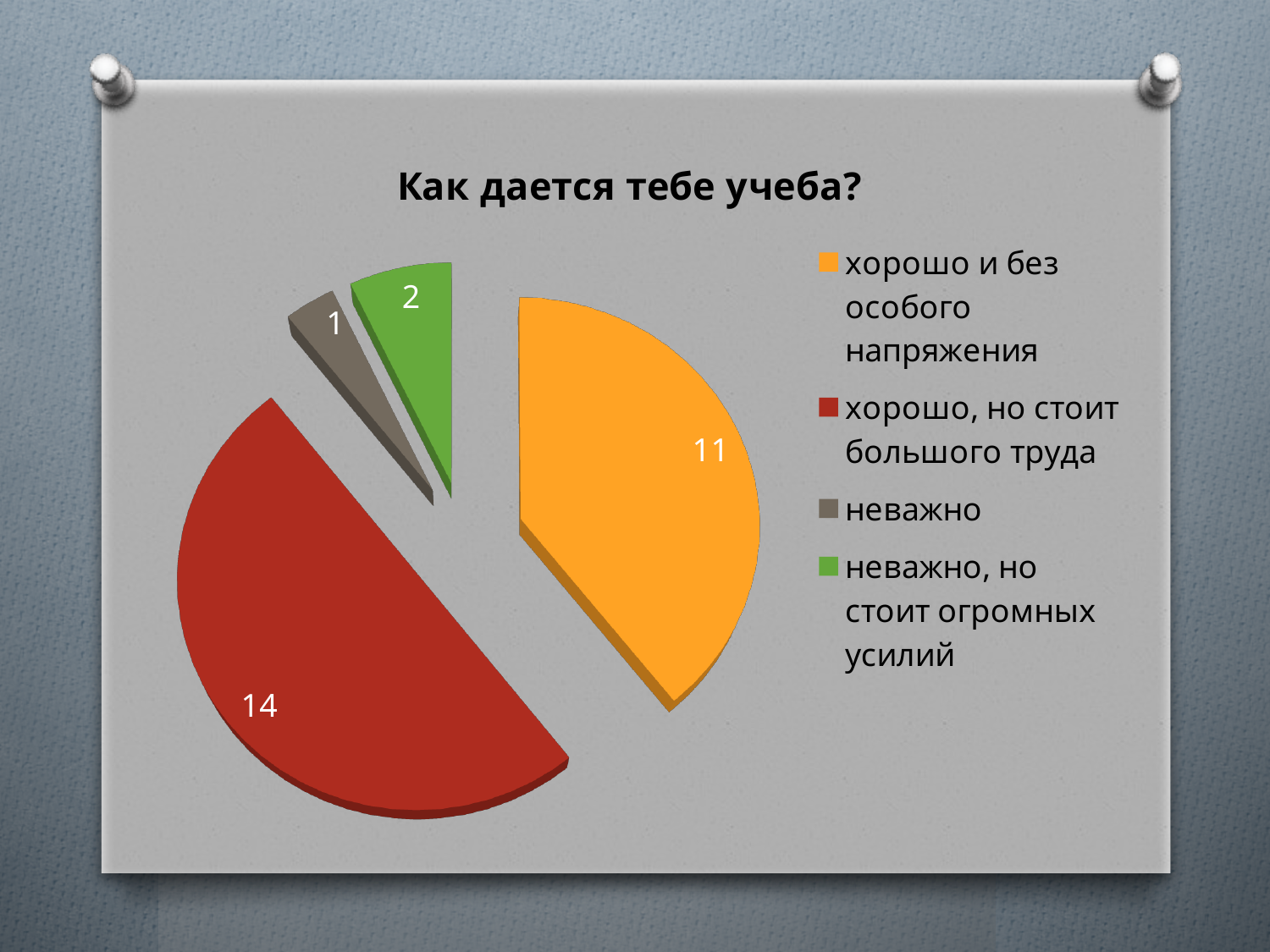
What is the total of all slices in the pie chart? 28 Which category has the largest slice? хорошо, но стоит большого труда What is the value for "хорошо, но стоит большого труда"? 14 What kind of chart is shown on the slide? pie chart What is the difference between the values for "хорошо, но стоит большого труда" and "хорошо и без особого напряжения"? 3 What is the value for "неважно"? 1 Which is larger: the value for "неважно, но стоит огромных усилий" or the value for "неважно"? неважно, но стоит огромных усилий What is the value for "неважно, но стоит огромных усилий"? 2 How many slices does the pie chart have? 4 What is the title of the chart? Как дается тебе учеба? What is the value for "хорошо и без особого напряжения"? 11 Which category has the smallest slice? неважно